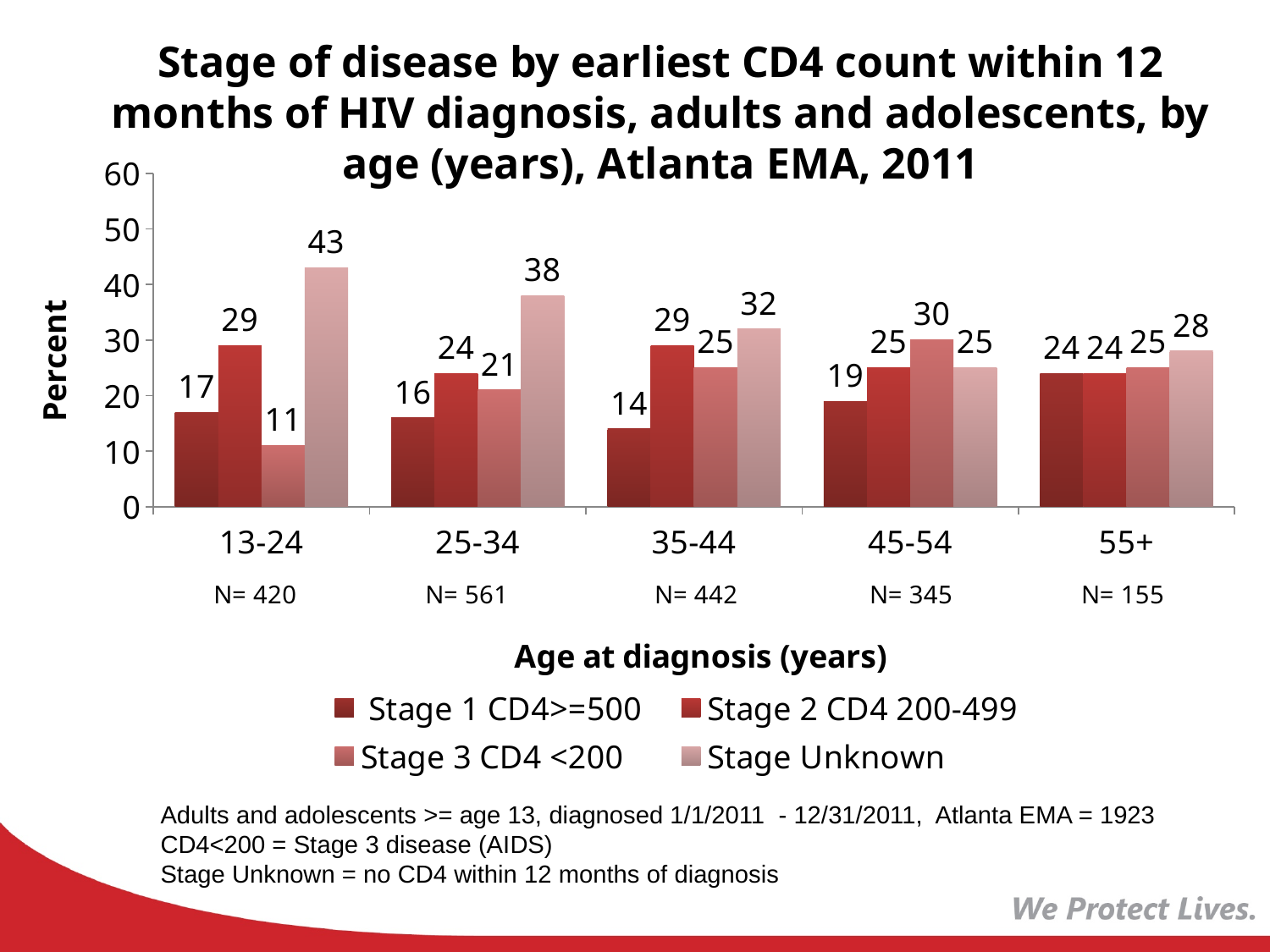
What kind of chart is shown on the slide? Bar chart What is the value for Stage Unknown in the 13-24 age group? 43 Which age group has the lowest value for Stage 3 CD4 <200? 13-24 Which age group has the highest value for Stage Unknown? 13-24 What is the value for Stage 1 CD4>=500 in the 35-44 age group? 14 How many age groups are shown on the x axis? 5 How many series does the legend list? 4 Which is larger in the 45-54 age group: Stage 3 CD4 <200 or Stage 1 CD4>=500? Stage 3 CD4 <200 What is the label of the y axis? Percent Do the Stage Unknown values rise or fall from the 13-24 group to the 55+ group? Fall What is the difference between the Stage Unknown value and the Stage 1 CD4>=500 value in the 13-24 age group? 26 What is the value for Stage 3 CD4 <200 in the 25-34 age group? 21